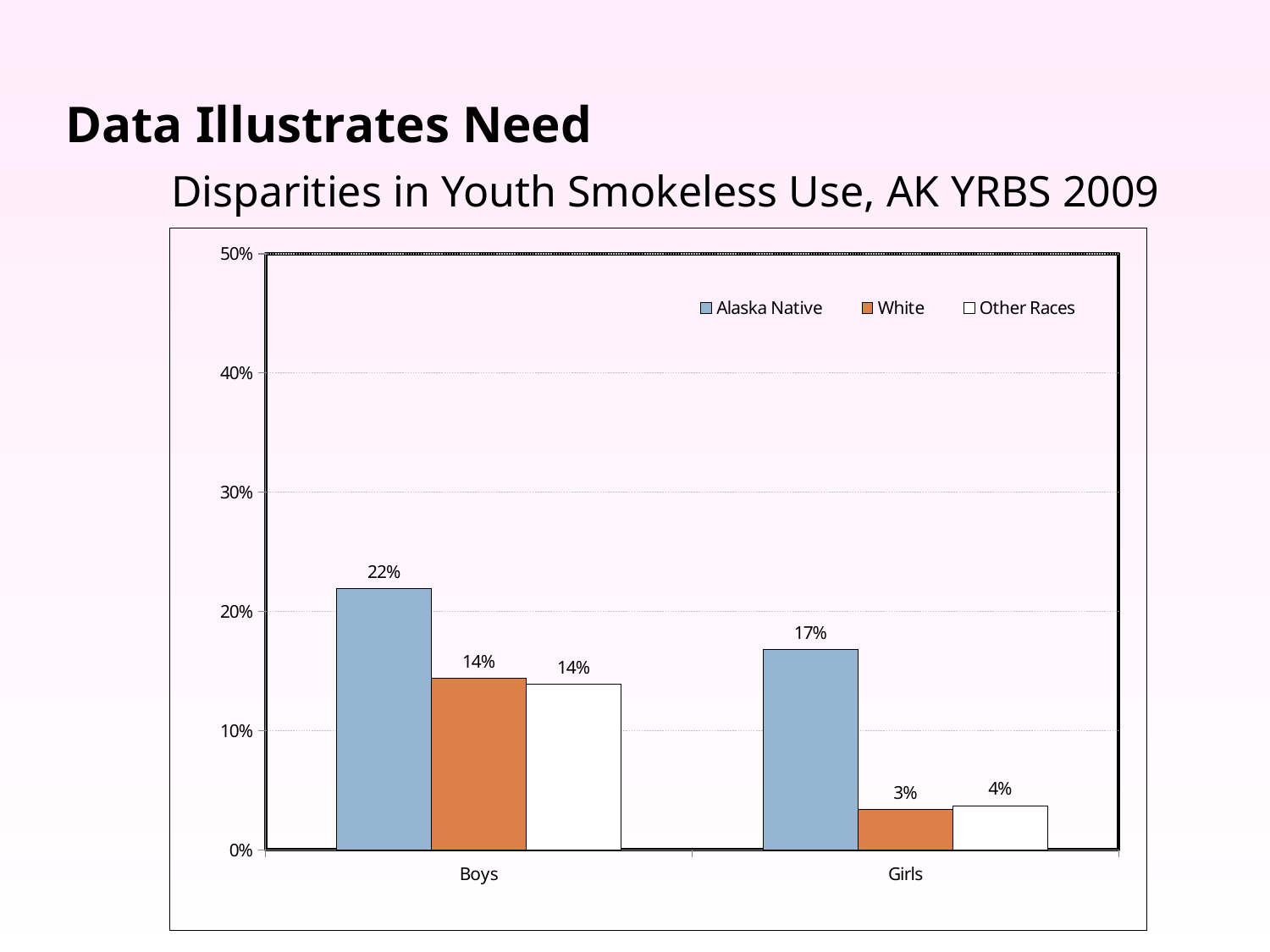
What is the value for White girls? 3% Which group has the highest value among boys? Alaska Native What is the value for Alaska Native girls? 17% How many series does the legend list? 3 Which group has the lowest value among girls? White What is the value for Other Races girls? 4% Which is larger, the White value for boys or the White value for girls? Boys What is the difference between the Alaska Native and White values for boys? 8% What is the difference between the Alaska Native value for boys and for girls? 5% What kind of chart is shown? Bar chart What is the value for Alaska Native boys? 22% What is the title of the chart? Disparities in Youth Smokeless Use, AK YRBS 2009